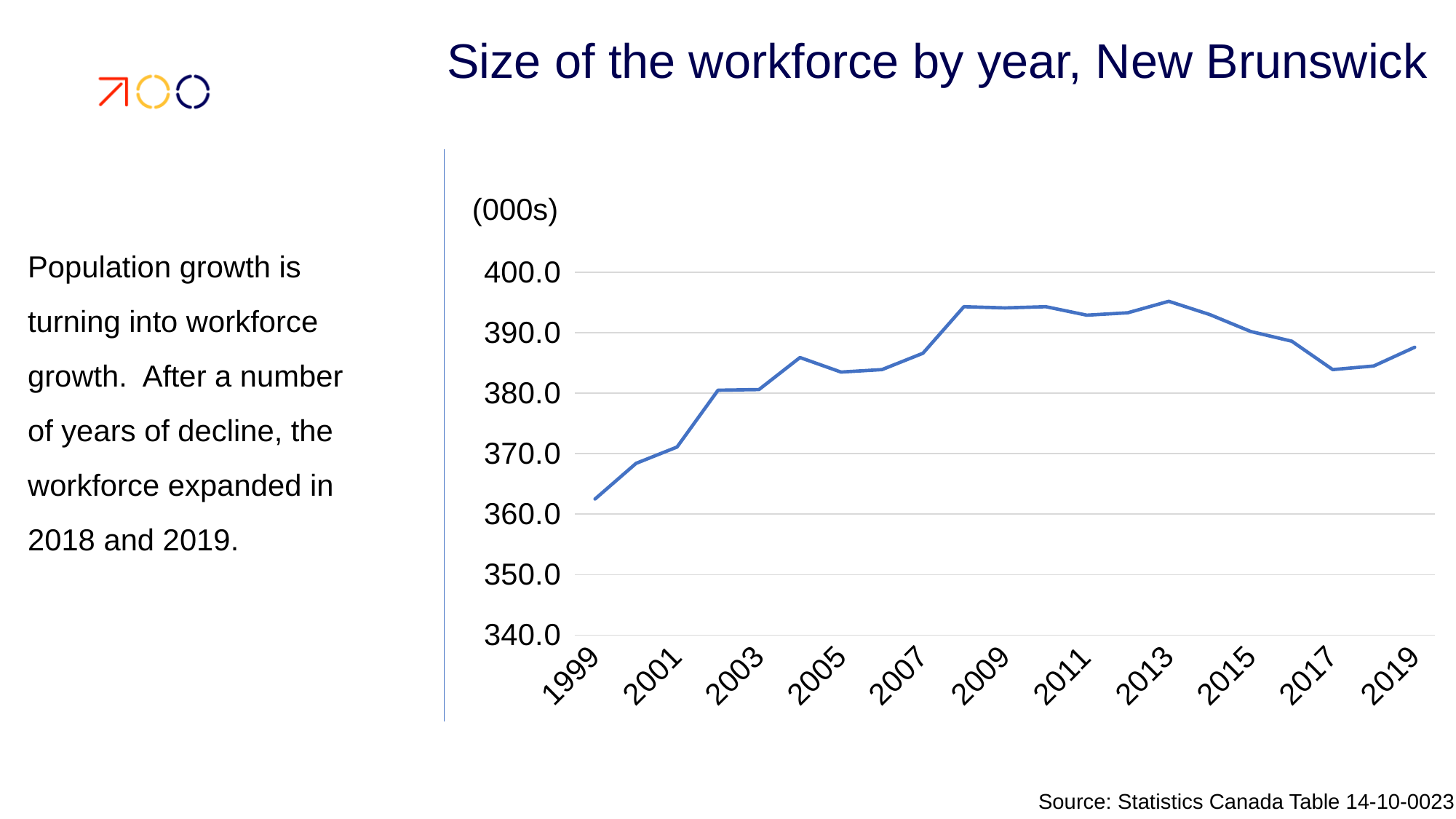
Does the workforce generally rise or fall between 1999 and 2008? rise Is the workforce value for 2009 greater or less than 390.0? greater Does the workforce rise or fall between 2013 and 2017? fall Which year has the lowest workforce value on the chart? 1999 Which year has the larger workforce value, 2001 or 2013? 2013 Is the workforce value for 2017 greater or less than 390.0? less What unit label is shown above the vertical axis of the chart? (000s) What type of chart is shown on the slide? line chart What is the title of the chart? Size of the workforce by year, New Brunswick Which year has the larger workforce value, 1999 or 2019? 2019 Is the workforce value for 1999 greater or less than 370.0? less